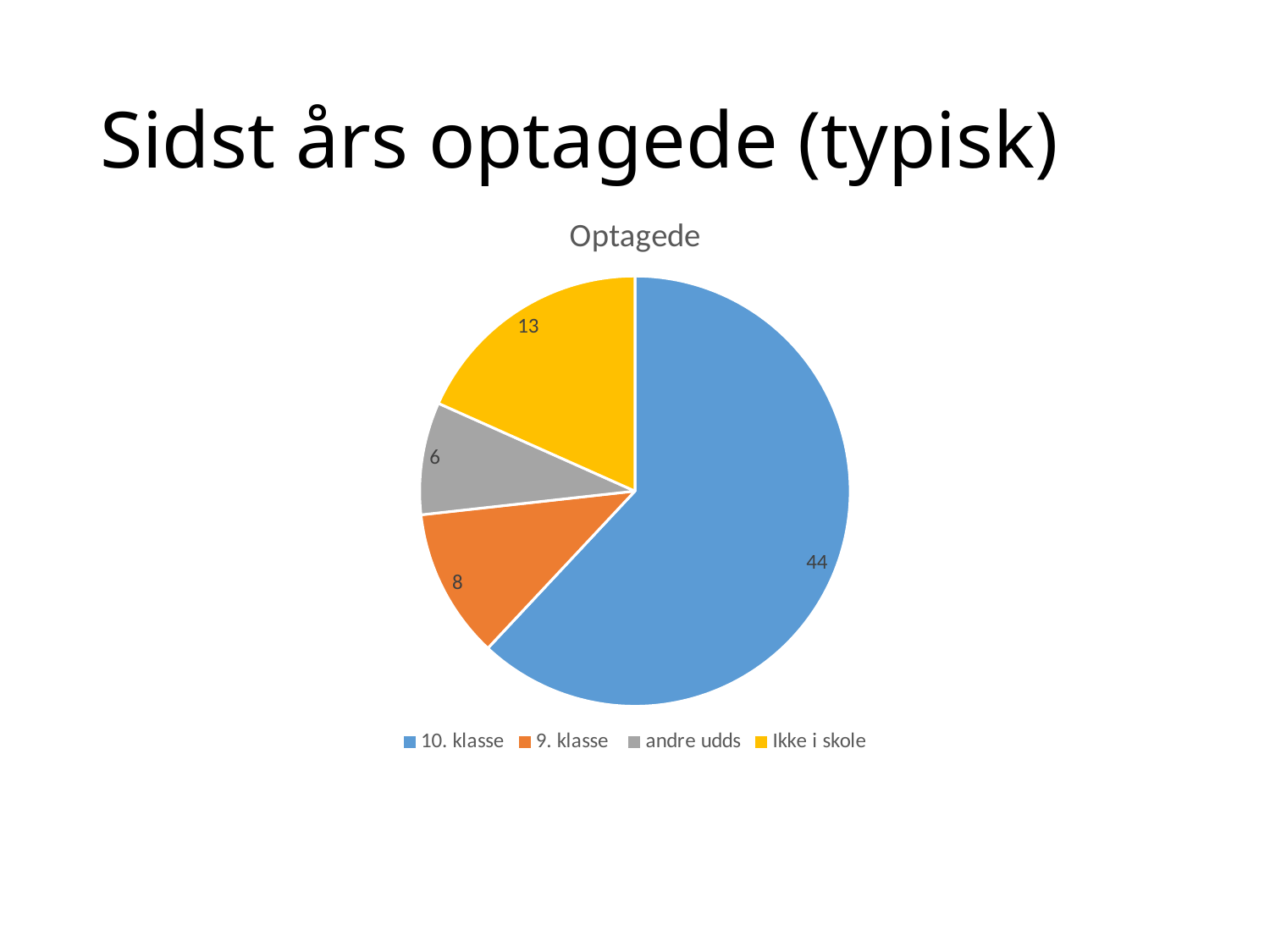
Which category has the smallest slice of the pie? andre udds What is the total of all the slice values in the pie chart? 71 What type of chart is shown on the slide? Pie chart What value is shown for the 10. klasse slice? 44 What value is shown for the andre udds slice? 6 How many slices does the pie chart have? 4 Which category has the largest slice of the pie? 10. klasse What is the difference between the 10. klasse value and the Ikke i skole value? 31 What value is shown for the 9. klasse slice? 8 Which is larger, the 9. klasse slice or the Ikke i skole slice? Ikke i skole What value is shown for the Ikke i skole slice? 13 What is the title of the chart? Optagede